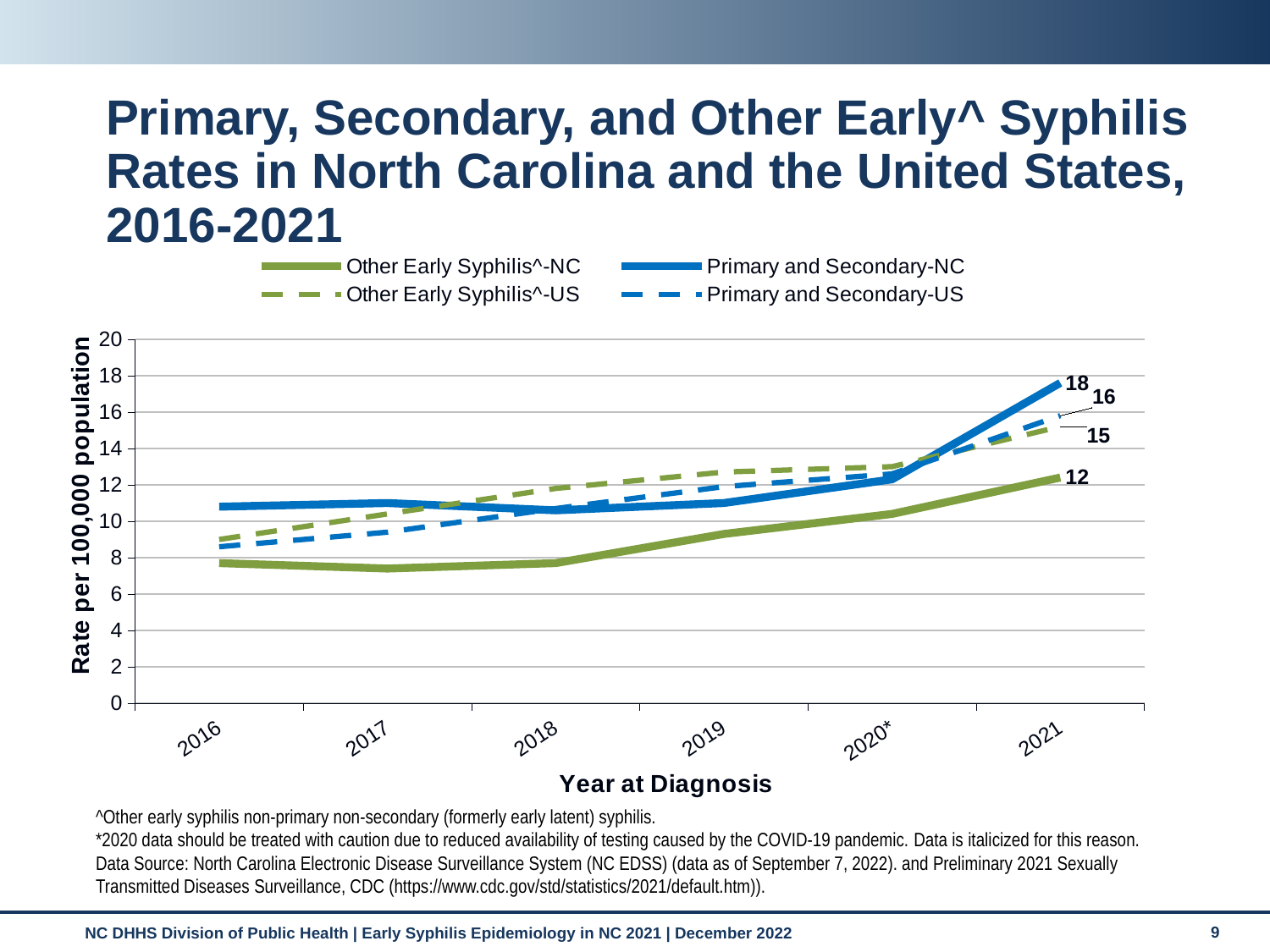
Which series has the lowest rate in 2021? Other Early Syphilis^-NC What is the Other Early Syphilis^-NC rate in 2021? 12 How many years are shown on the x axis? 6 What type of chart is shown on the slide? line chart What is the difference between the Primary and Secondary-NC rate and the Other Early Syphilis^-NC rate in 2021? 6 What is the Primary and Secondary-US rate in 2021? 16 How many series does the legend list? 4 What is the label of the y axis? Rate per 100,000 population Which series has the highest rate in 2021? Primary and Secondary-NC What is the Other Early Syphilis^-US rate in 2021? 15 What is the Primary and Secondary-NC rate in 2021? 18 Is the Other Early Syphilis^-NC rate in 2016 greater or less than 10? less